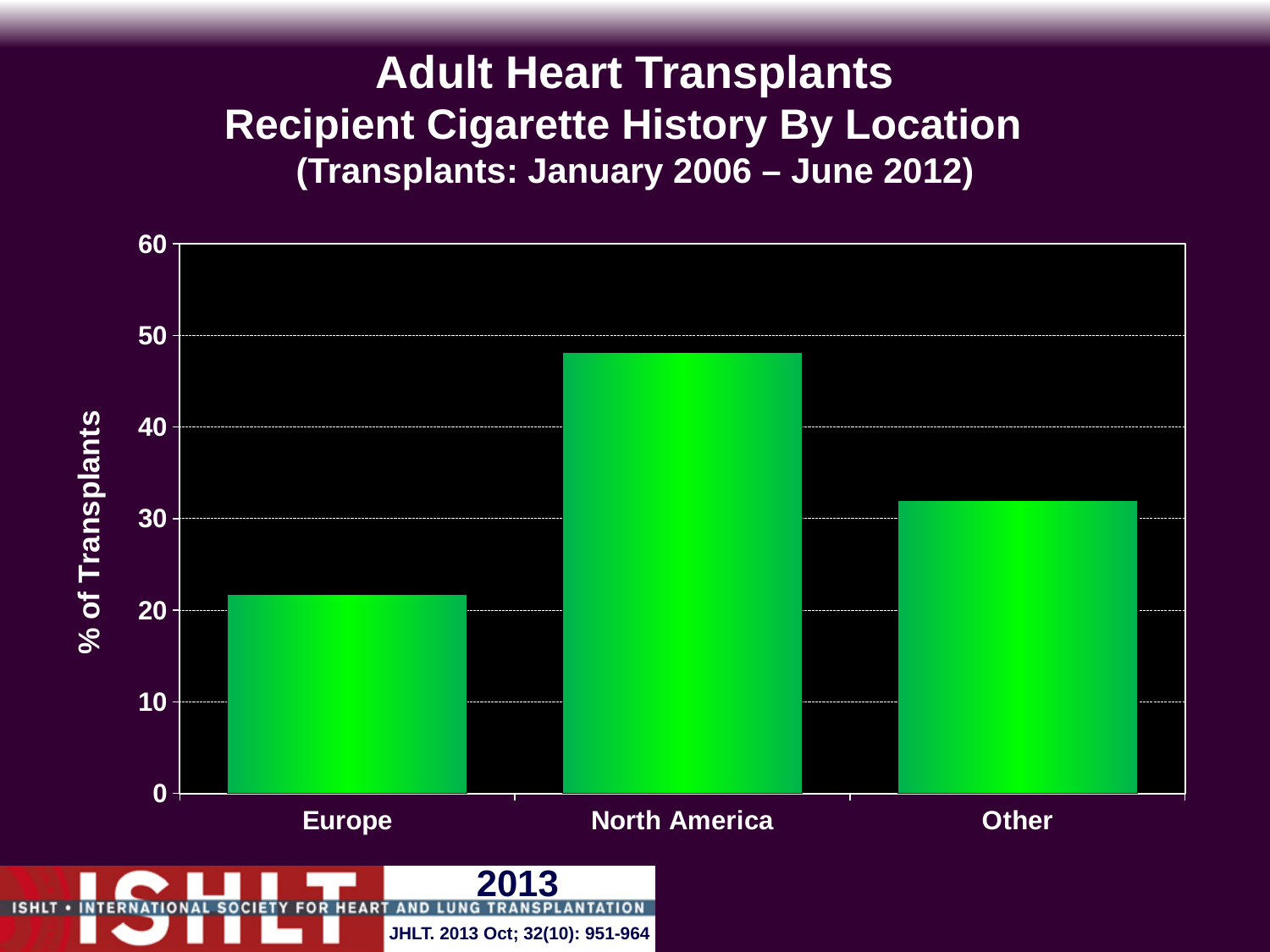
Is the value for Other greater or less than 30? greater Which location has the lowest % of transplants? Europe How many location categories are shown on the x axis? 3 What is the label of the y axis? % of Transplants Is the value for North America greater or less than 40? greater What is the maximum value shown on the y axis? 60 What time period of transplants does the chart title cover? January 2006 – June 2012 Is the value for North America greater or less than 50? less What kind of chart is shown on the slide? bar chart Which location has the highest % of transplants? North America Which is larger, the value for Other or the value for Europe? Other